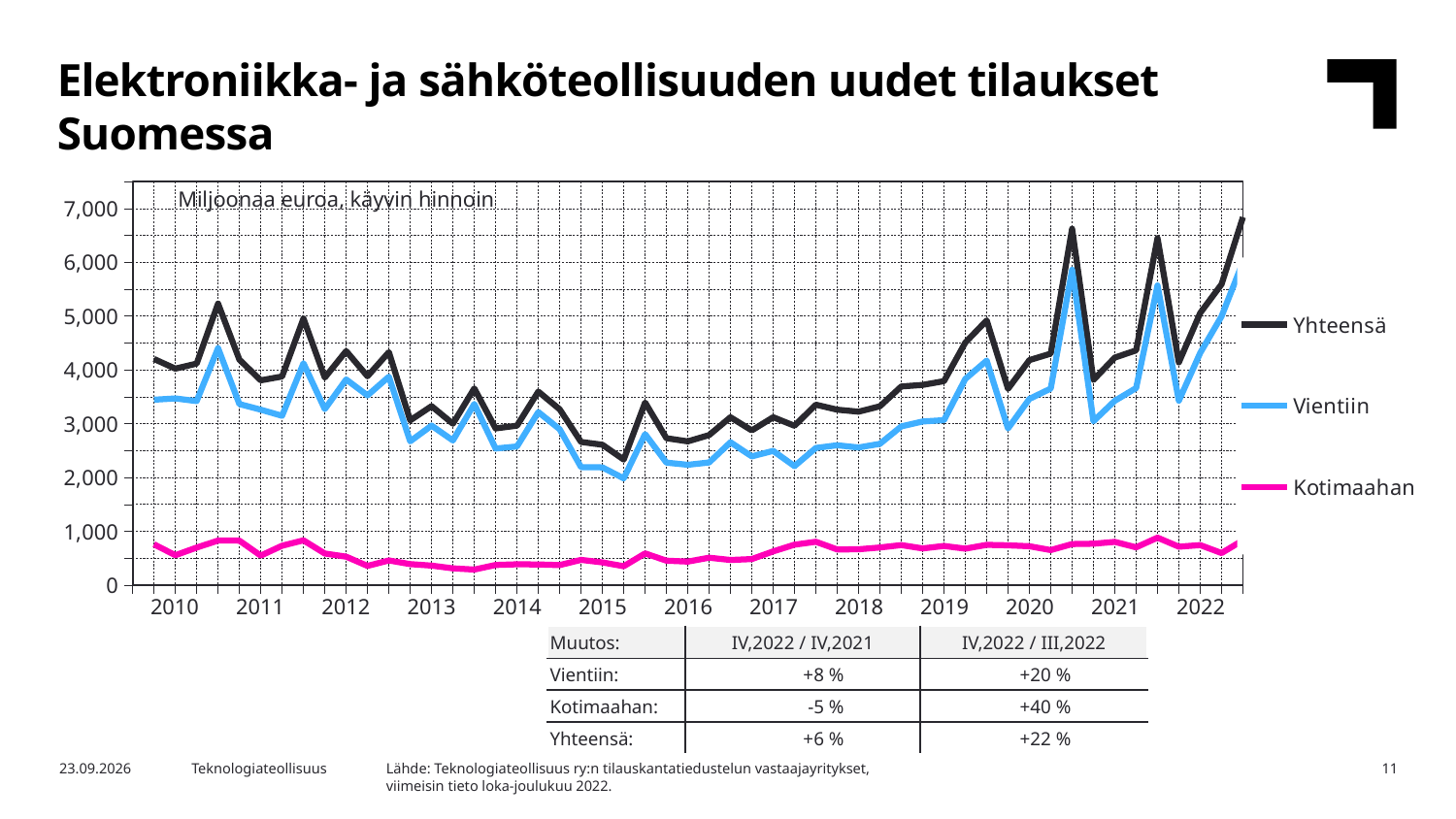
Is the highest value of Kotimaahan greater or less than 1,000? less Which series is larger in 2021, Vientiin or Kotimaahan? Vientiin Which series is plotted with the pink line? Kotimaahan Does the Yhteensä line generally rise or fall from 2019 to 2022? rise How many series does the legend list? 3 Is the lowest value of Yhteensä, reached around 2015, greater or less than 3,000? less Is the value for Yhteensä at the last point in 2022 greater or less than 6,000? greater Which series has the lowest values throughout the chart? Kotimaahan Which series has the highest values throughout the chart? Yhteensä What unit label is shown at the top of the chart area? Miljoonaa euroa, käyvin hinnoin What kind of chart is shown on the slide? line chart